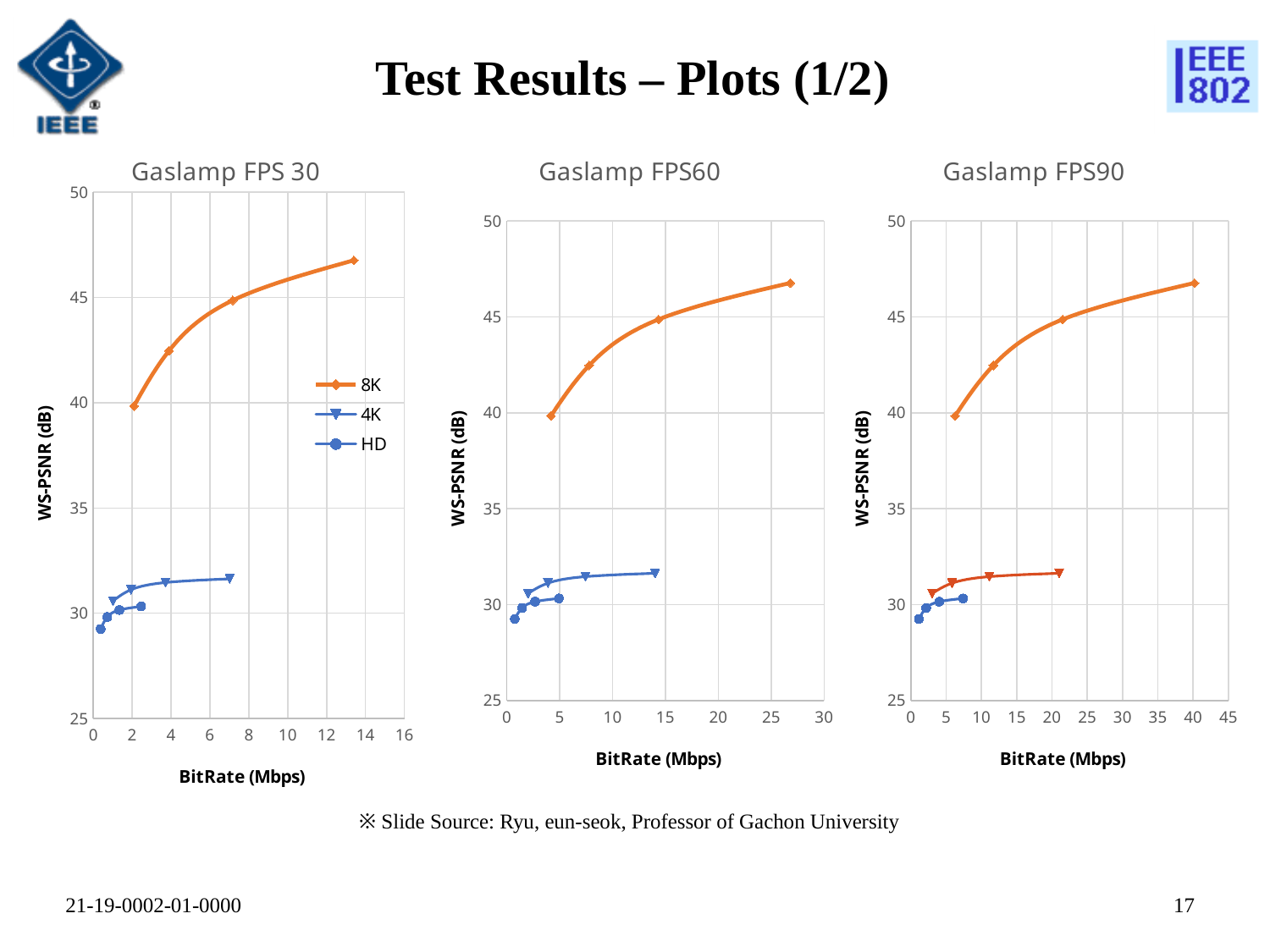
In the Gaslamp FPS90 chart, which series has the lowest WS-PSNR values? HD What kind of chart is the Gaslamp FPS 30 chart? line chart In the Gaslamp FPS90 chart, does the WS-PSNR of the 8K series rise or fall as bitrate increases? rise In the Gaslamp FPS 30 chart, which series has the highest WS-PSNR values? 8K In the Gaslamp FPS60 chart, is the WS-PSNR of the 8K series at its highest bitrate greater or less than 45? greater In the Gaslamp FPS60 chart, which series reaches higher WS-PSNR values, 8K or 4K? 8K How many charts are shown on the slide? 3 How many data points does the 8K series have in the Gaslamp FPS60 chart? 4 How many series does the legend on the Gaslamp FPS 30 chart list? 3 In the Gaslamp FPS 30 chart, is the WS-PSNR of the 4K series at its highest bitrate greater or less than 35? less What are the series names in the legend of the Gaslamp FPS 30 chart? 8K, 4K, HD What is the x-axis label on the Gaslamp FPS60 chart? BitRate (Mbps)